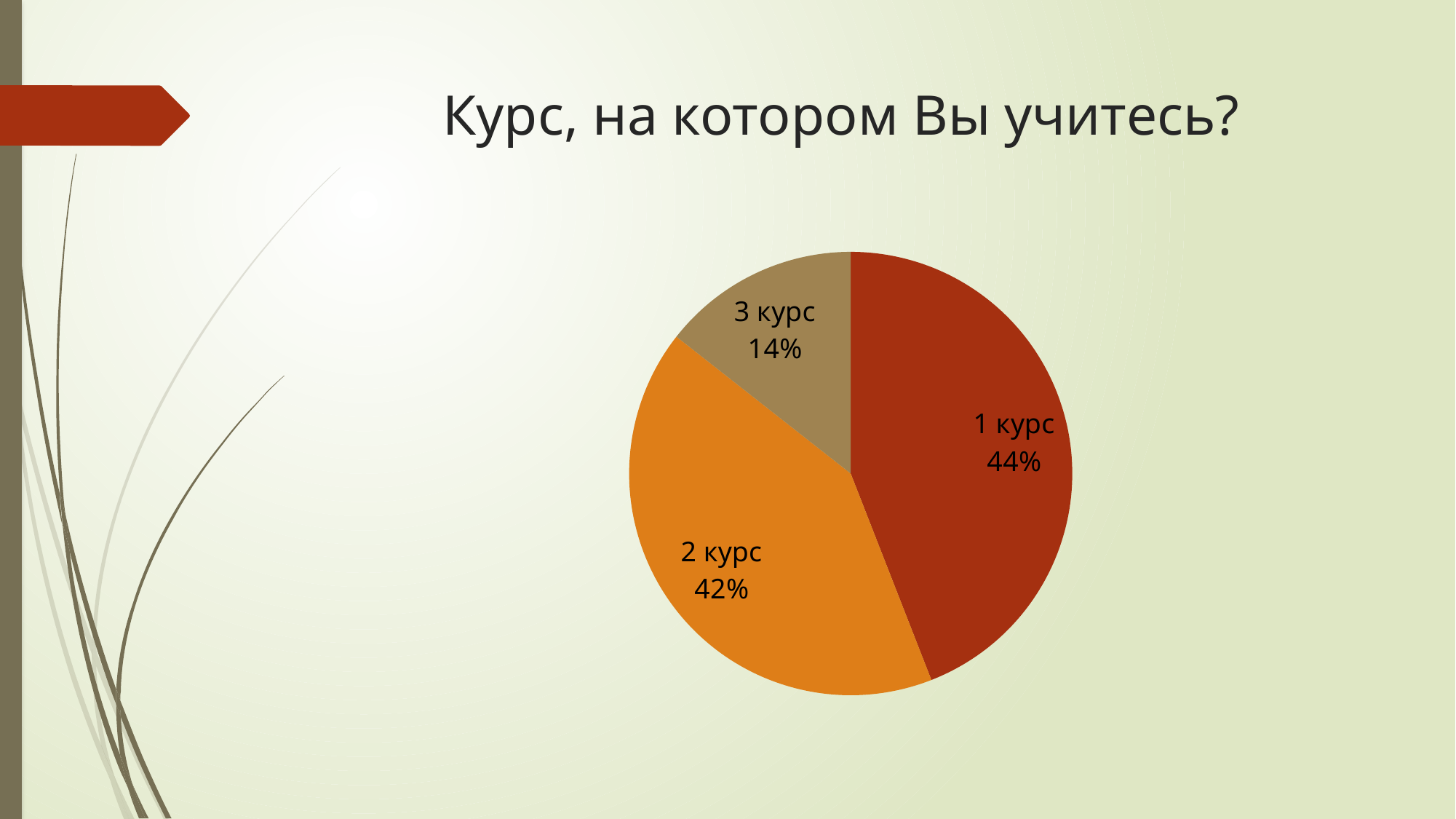
What share of the pie does 2 курс have? 42% What is the difference in percentage points between 2 курс and 3 курс? 28% What colour is the slice for 2 курс? orange What share of the pie does 3 курс have? 14% Which is larger, the share for 2 курс or the share for 3 курс? 2 курс Which category has the largest slice of the pie? 1 курс What is the title of the slide? Курс, на котором Вы учитесь? What share of the pie does 1 курс have? 44% Which category has the smallest slice of the pie? 3 курс What is the difference in percentage points between 1 курс and 3 курс? 30% What kind of chart is shown on the slide? pie chart How many categories are shown in the pie chart? 3